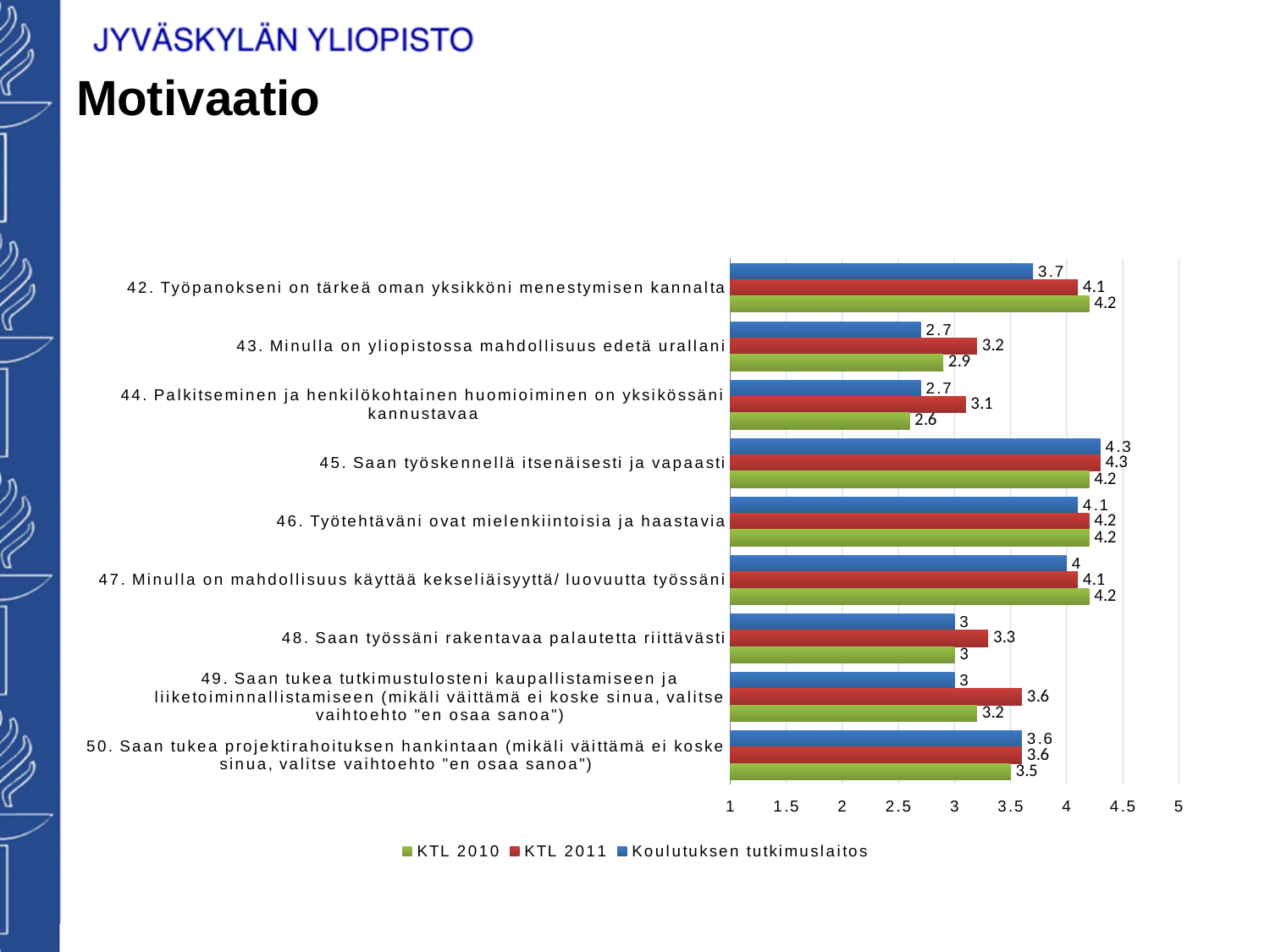
What is the KTL 2010 value for statement 49 (Saan tukea tutkimustulosteni kaupallistamiseen ja liiketoiminnallistamiseen)? 3.2 Is the KTL 2010 value for statement 42 greater or less than 4? greater What is the difference between the KTL 2011 and Koulutuksen tutkimuslaitos values for statement 49? 0.6 What kind of chart is shown on the slide? bar chart Which statement has the highest Koulutuksen tutkimuslaitos value? 45. Saan työskennellä itsenäisesti ja vapaasti What is the Koulutuksen tutkimuslaitos value for statement 43 (Minulla on yliopistossa mahdollisuus edetä urallani)? 2.7 What is the KTL 2011 value for statement 42 (Työpanokseni on tärkeä oman yksikköni menestymisen kannalta)? 4.1 Which statement has the lowest KTL 2010 value? 44. Palkitseminen ja henkilökohtainen huomioiminen on yksikössäni kannustavaa For statement 48 (Saan työssäni rakentavaa palautetta riittävästi), which is larger: the KTL 2011 value or the KTL 2010 value? KTL 2011 How many statements (categories) are plotted on the chart? 9 How many series does the legend list? 3 Which colour represents the KTL 2011 series in the chart? red